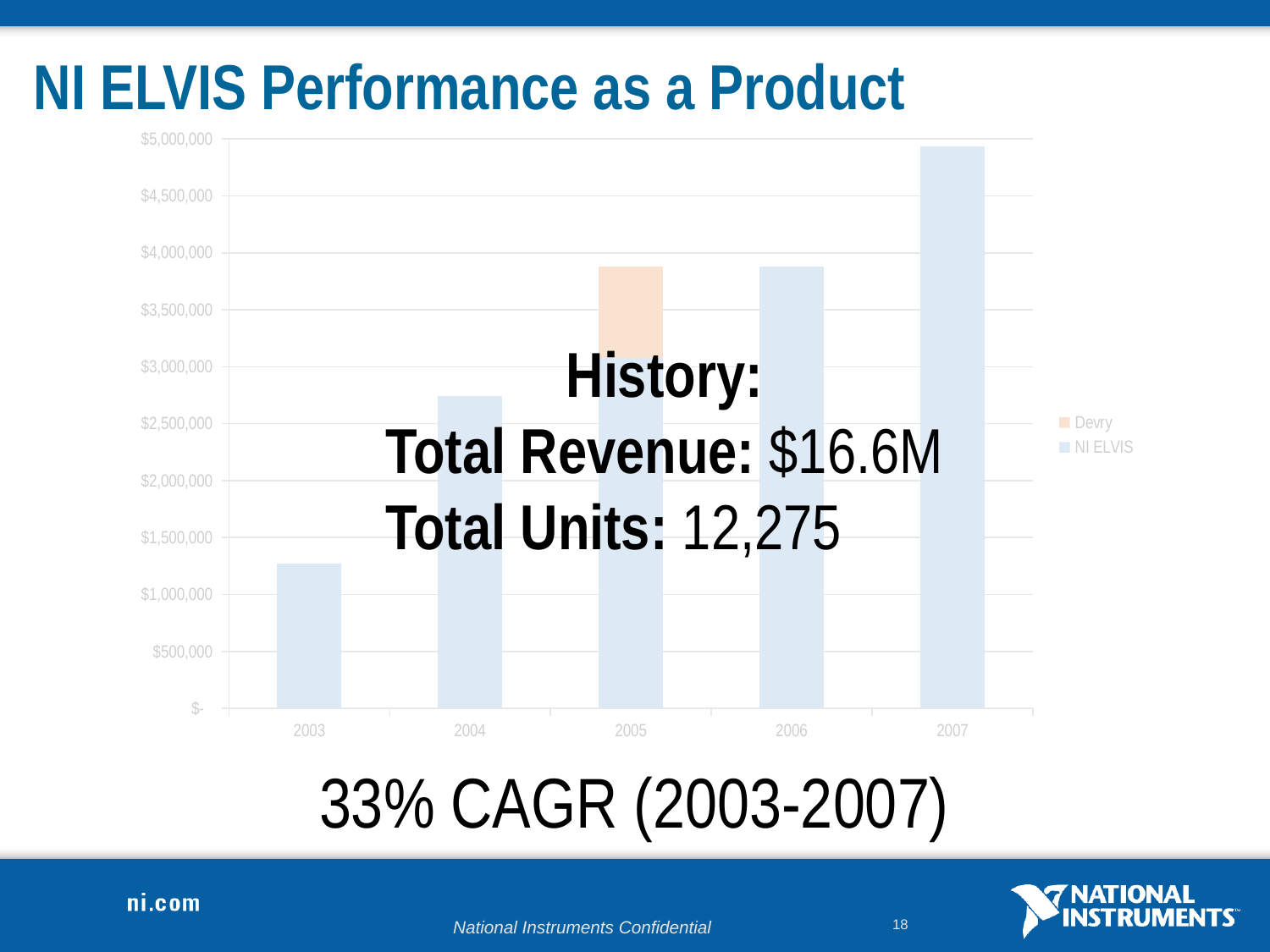
Is the value for 2004 greater or less than $2,500,000? greater Is the NI ELVIS value for 2006 greater or less than $3,500,000? greater Is the value for 2007 greater or less than $4,500,000? greater How many years are shown on the x axis of the chart? 5 Which year has the highest total bar in the chart? 2007 How many series does the chart's legend list? 2 Which year has the lowest bar in the chart? 2003 Which is larger, the bar for 2004 or the bar for 2007? 2007 What kind of chart is shown on the slide? bar chart Which year is the only one with a Devry segment in its bar? 2005 Do the bar values generally rise or fall from 2003 to 2007? rise